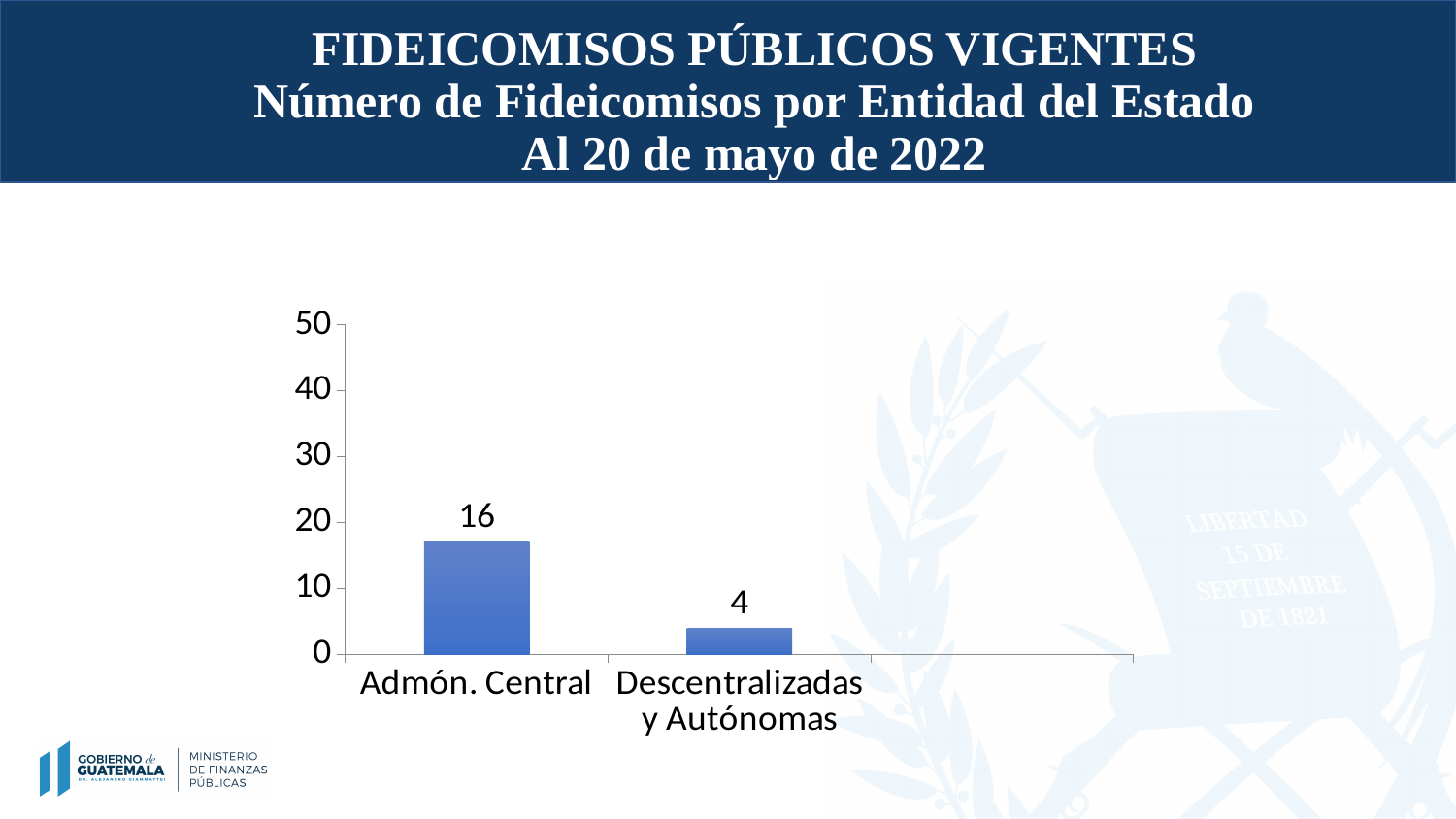
What is the highest value shown on the y axis? 50 What is the value for Descentralizadas y Autónomas? 4 What kind of chart is shown on the slide? Bar chart What is the total of the two bars shown? 20 Which category has the lowest value? Descentralizadas y Autónomas What is the value for Admón. Central? 16 Is the value for Descentralizadas y Autónomas greater or less than 10? less What is the difference between the values for Admón. Central and Descentralizadas y Autónomas? 12 Is the value for Admón. Central greater or less than 20? less Which category has the highest value? Admón. Central How many categories are shown on the x axis? 2 Which is larger, the value for Admón. Central or for Descentralizadas y Autónomas? Admón. Central